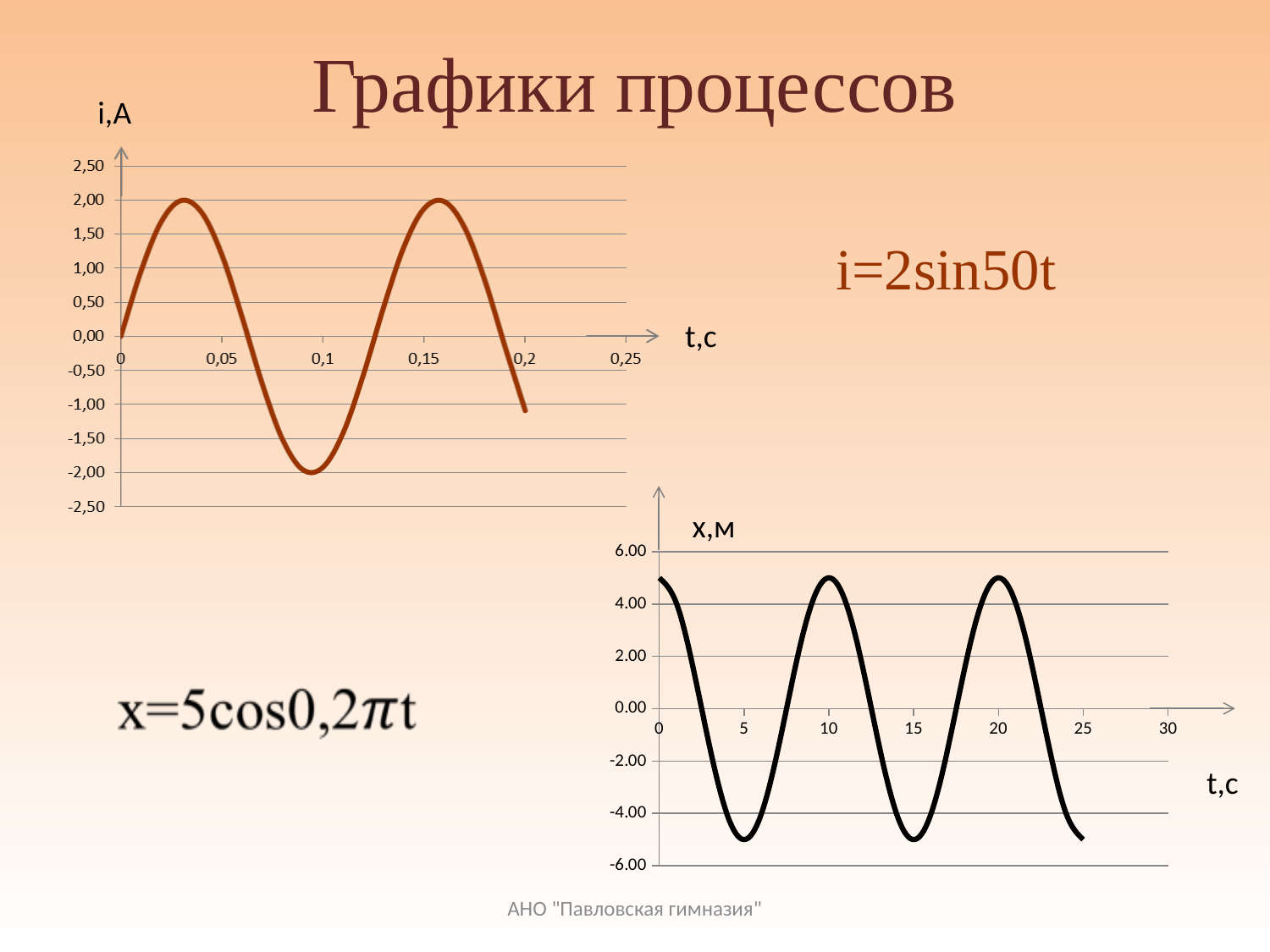
In the bottom-right chart (x,м versus t,c), does the curve rise or fall between t = 0 and t = 5? fall In the top-left chart (i,A versus t,c), what is the value of i at t = 0? 0,00 In the bottom-right chart (x,м versus t,c), how many peaks (maxima) does the curve show? 3 What kind of chart is the top-left chart (i,A versus t,c)? line chart In the bottom-right chart (x,м versus t,c), is the value at t = 0 greater or less than 4.00? greater In the bottom-right chart (x,м versus t,c), does the curve rise or fall between t = 5 and t = 10? rise How many charts are shown on the slide? 2 In the top-left chart (i,A versus t,c), what is the maximum value reached by the curve? 2,00 What is the title of the slide containing the two charts? Графики процессов In the bottom-right chart (x,м versus t,c), is the value at t = 5 greater or less than -4.00? less In the top-left chart (i,A versus t,c), what is the minimum value reached by the curve? -2,00 In the top-left chart (i,A versus t,c), is the value at t = 0,2 greater or less than -1,50? greater